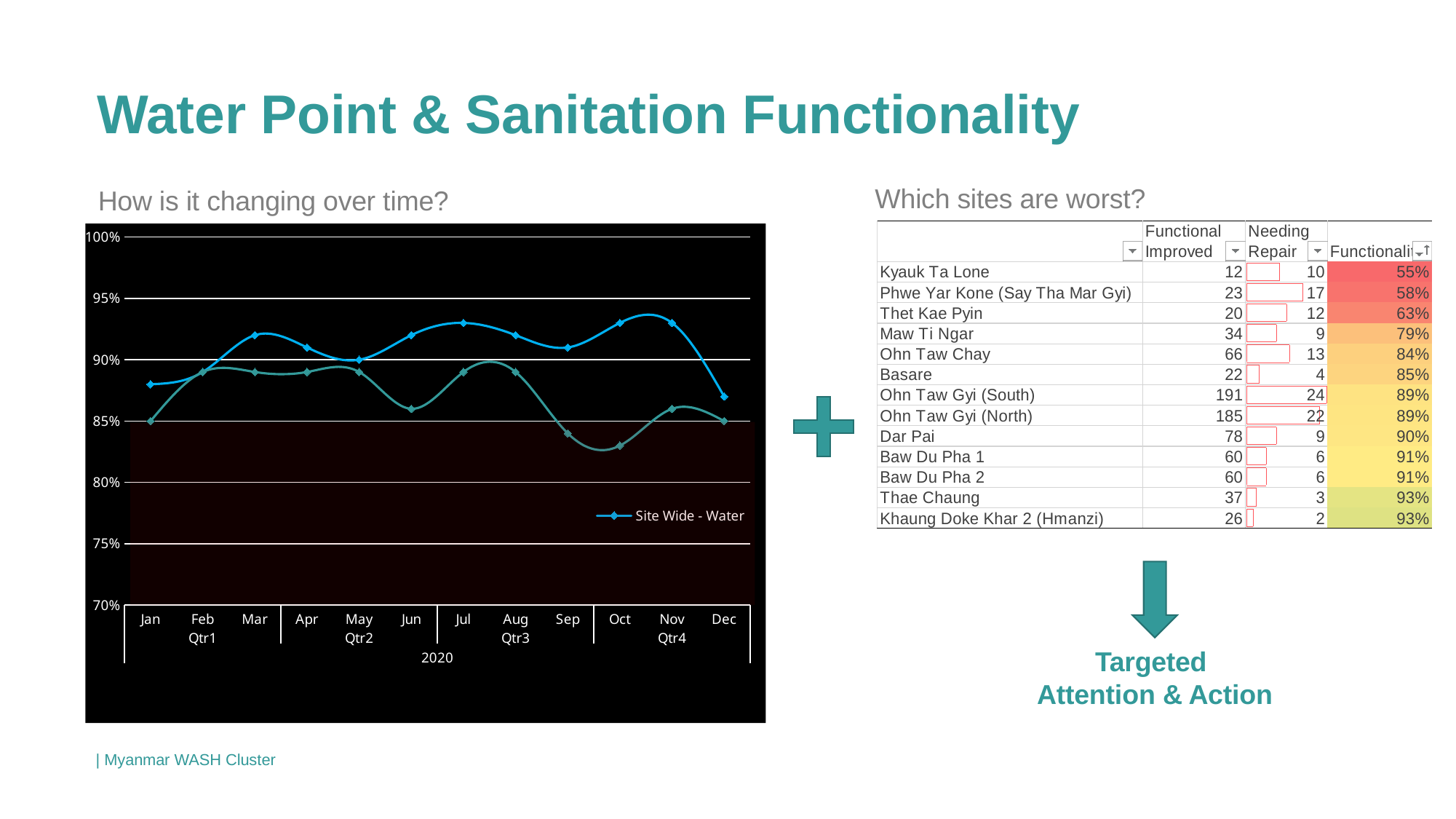
In the line chart, is the Site Wide - Water value for Nov greater or less than 90%? greater What year is shown on the x axis of the line chart? 2020 What kind of chart is shown under "How is it changing over time?"? line chart In the line chart, is the value of the lower (teal) line for Oct greater or less than 85%? less In the line chart, does the Site Wide - Water line rise or fall from Nov to Dec? fall In the line chart, is the Site Wide - Water value for Jul greater or less than 90%? greater What is the name of the series listed in the legend of the line chart? Site Wide - Water How many series does the legend of the line chart list? 1 How many months are plotted along the x axis of the line chart? 12 In the line chart, which line is higher in Jul, the Site Wide - Water line or the lower (teal) line? Site Wide - Water